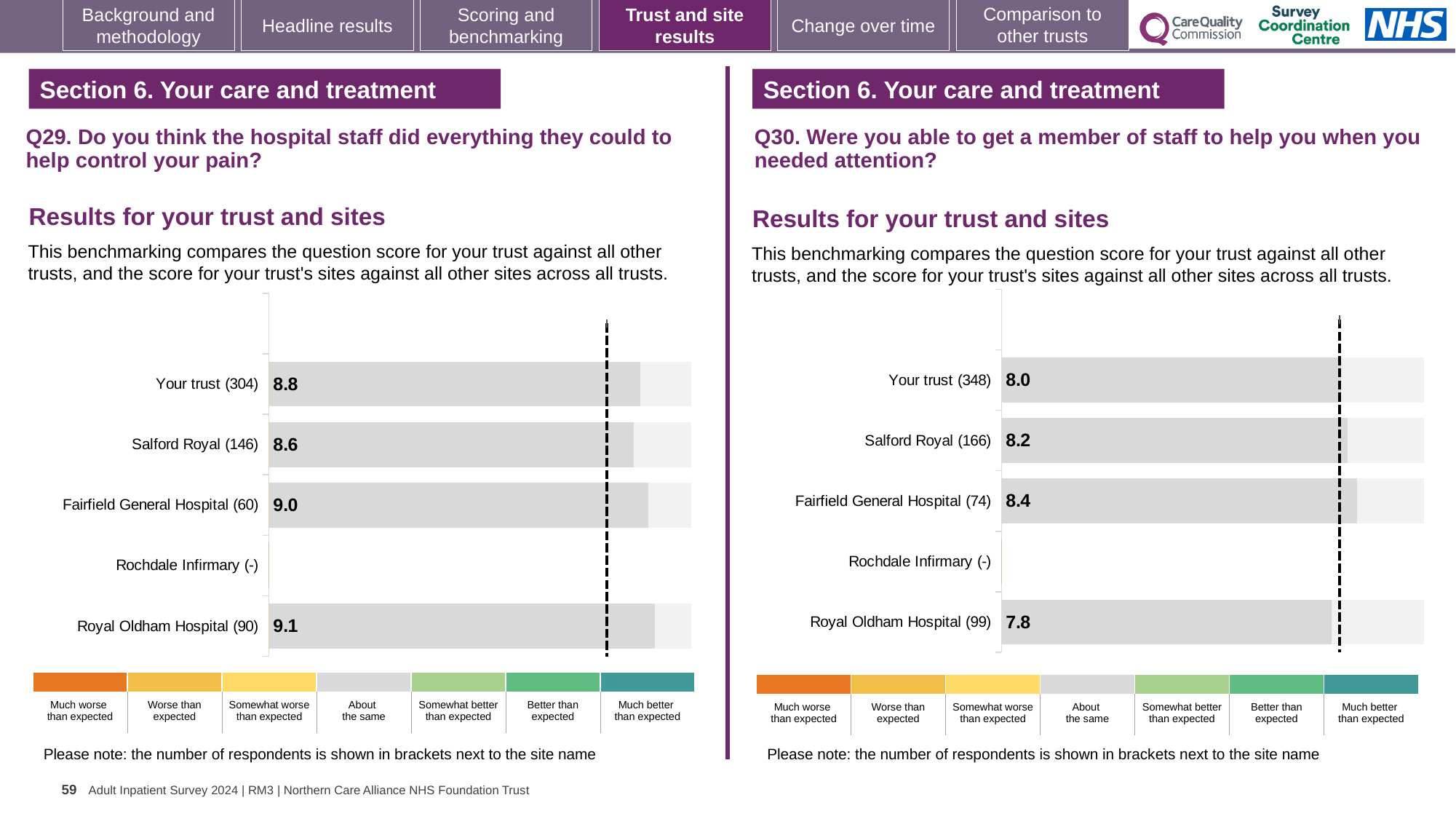
In the Q29 chart on the left, which site has the highest score? Royal Oldham Hospital In the Q30 chart on the right, what is the difference between the scores for Fairfield General Hospital and Your trust? 0.4 In the Q29 chart on the left, what is the score for Your trust? 8.8 In the Q30 chart on the right, which site has the highest score? Fairfield General Hospital In the Q29 chart on the left, which site with a score shown has the lowest score? Salford Royal How many site rows are listed in the Q29 chart on the left? 5 In the Q30 chart on the right, which is larger, the score for Your trust or the score for Royal Oldham Hospital? Your trust In the Q29 chart on the left, what is the score for Fairfield General Hospital? 9.0 What kind of chart is used for the Q30 results on the right? Bar chart In the Q29 chart on the left, what is the difference between the scores for Royal Oldham Hospital and Salford Royal? 0.5 In the Q30 chart on the right, what is the score for Salford Royal? 8.2 In the Q30 chart on the right, what is the score for Royal Oldham Hospital? 7.8